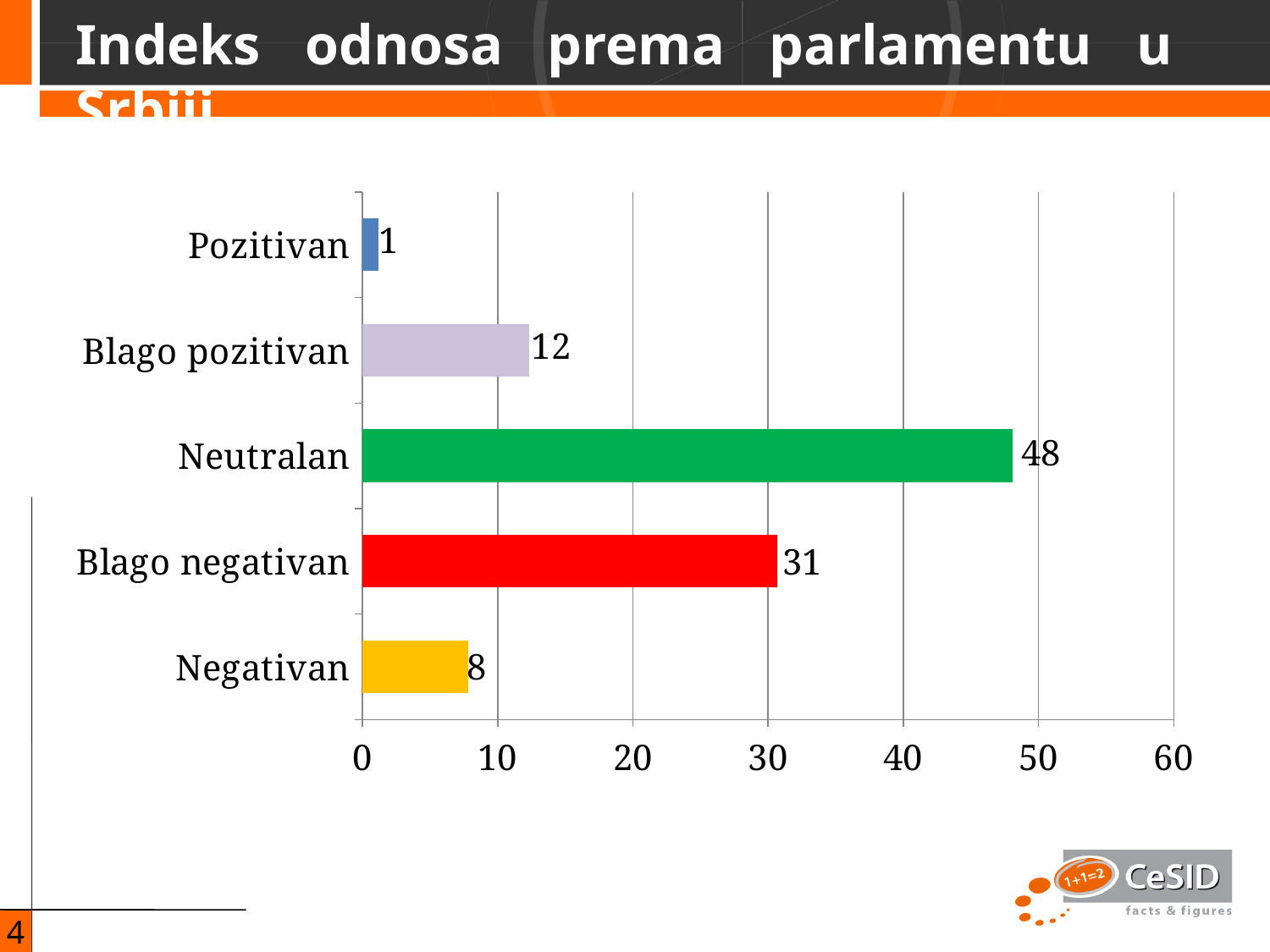
What kind of chart is shown on the slide? bar chart Which category has the highest value? Neutralan Which category has the lowest value? Pozitivan How many categories are shown in the chart? 5 What is the value for Neutralan? 48 What colour is the bar for Neutralan? green What is the value for Blago negativan? 31 What is the difference between the values for Neutralan and Blago negativan? 17 What is the value for Blago pozitivan? 12 Is the value for Neutralan greater or less than 40? greater What is the value for Negativan? 8 Which is larger, the value for Blago pozitivan or the value for Negativan? Blago pozitivan